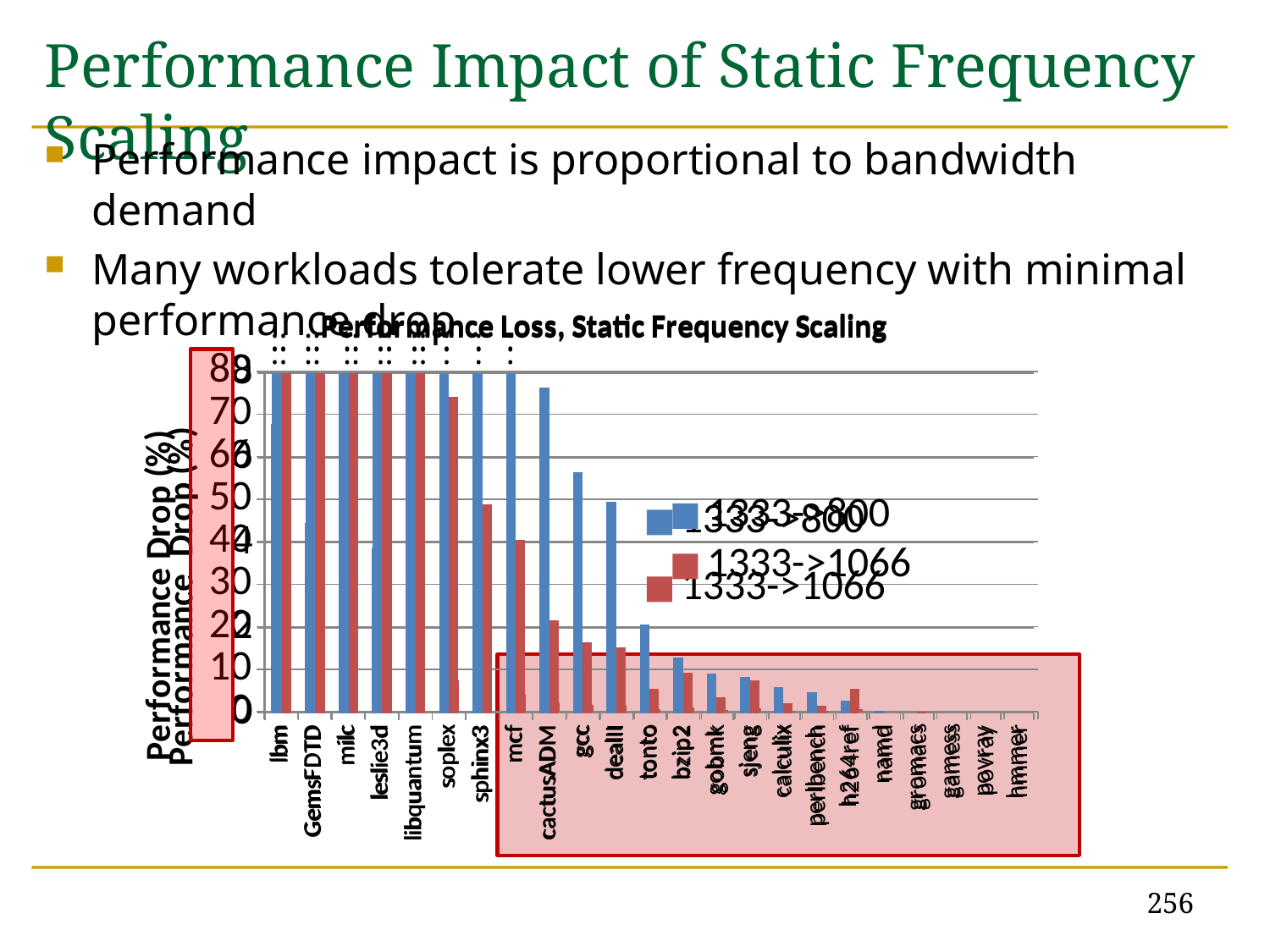
Do the 1333->800 values generally rise or fall moving from left to right along the x axis? fall What is the title of the chart? Performance Loss, Static Frequency Scaling How many series does the chart legend list? 2 Is the 1333->800 value for tonto greater or less than 30? less For gcc, which series has the larger performance drop, 1333->800 or 1333->1066? 1333->800 What kind of chart is shown on the slide? bar chart Which colour represents the 1333->1066 series in the chart? red How many workload categories are shown on the x axis of the chart? 23